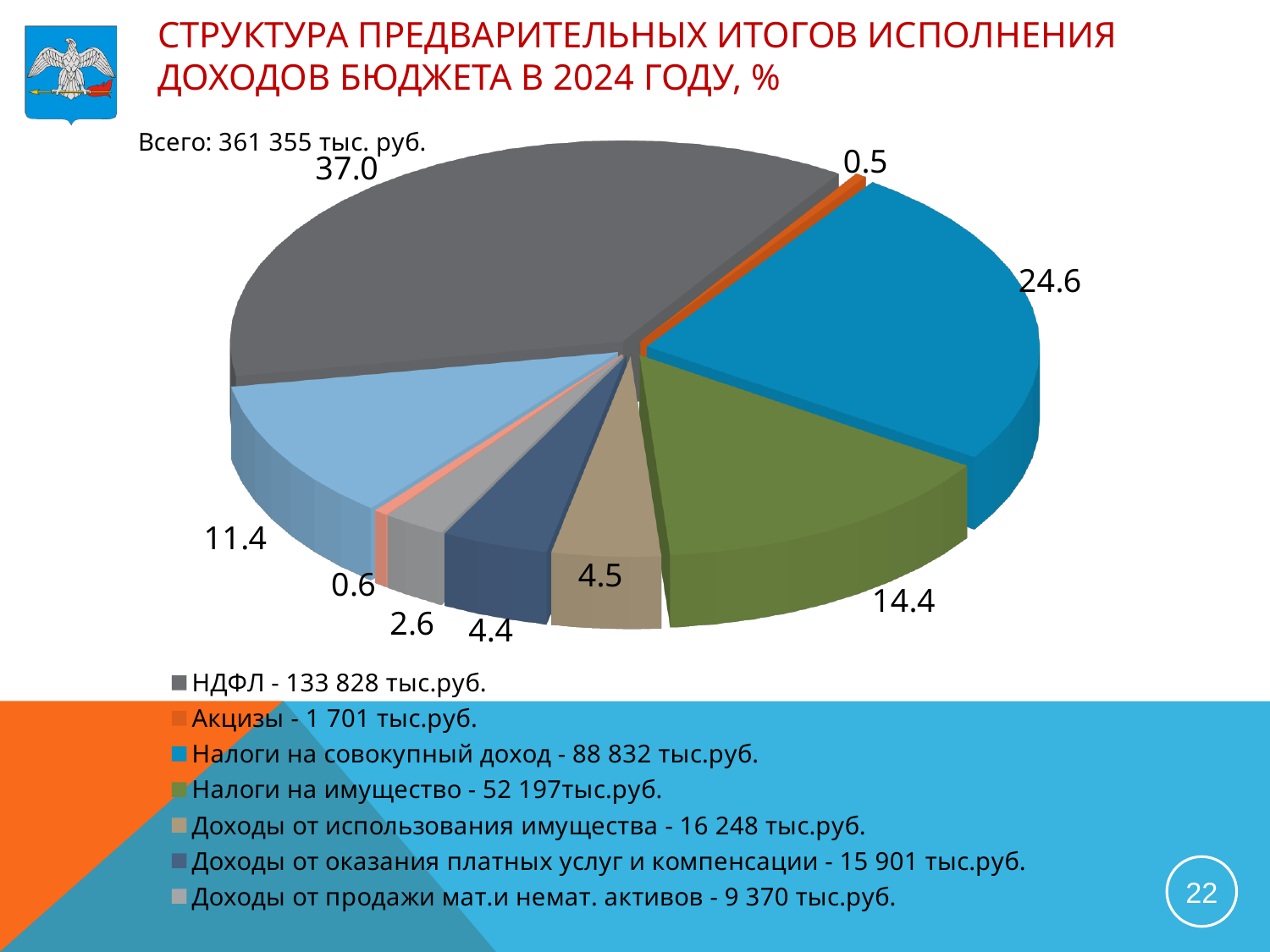
Which category has the largest share of the pie chart? НДФЛ What percentage share does Доходы от продажи мат.и немат. активов have in the pie chart? 2.6 What is the difference in percentage points between the НДФЛ share and the Налоги на совокупный доход share? 12.4 What percentage share does Акцизы have in the pie chart? 0.5 What percentage share does Налоги на совокупный доход have in the pie chart? 24.6 How many slices does the pie chart have? 9 What percentage share does Налоги на имущество have in the pie chart? 14.4 Which has a larger share: Доходы от использования имущества or Доходы от оказания платных услуг и компенсации? Доходы от использования имущества What total amount is stated above the pie chart? 361 355 тыс. руб. Which category has the smallest share of the pie chart? Акцизы What kind of chart is shown on the slide? pie chart What percentage share does НДФЛ have in the pie chart? 37.0